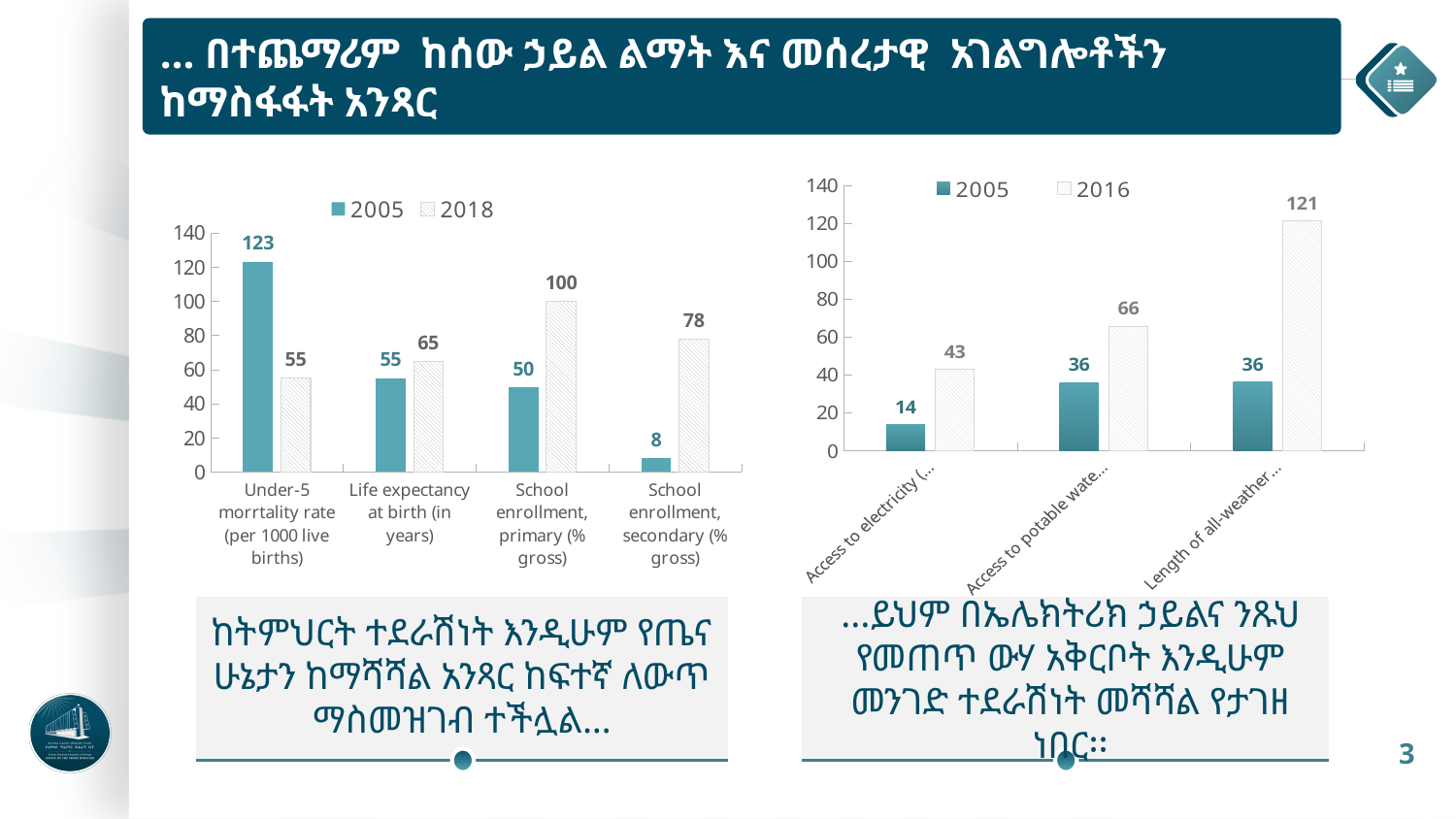
On the left chart, which category has the lowest 2005 value? School enrollment, secondary (% gross) On the right chart, what is the difference between the 2016 and 2005 values for Access to potable water? 30 On the left chart, which two years does the legend list? 2005 and 2018 On the left chart, what is the 2018 value for School enrollment, secondary (% gross)? 78 What type of chart is the right chart? Bar chart On the right chart, which category has the highest 2016 value? Length of all-weather On the left chart, what is the difference between the 2018 and 2005 values for School enrollment, primary (% gross)? 50 On the left chart, what is the 2005 value for Under-5 mortality rate (per 1000 live births)? 123 On the left chart, how many categories are shown on the x axis? 4 On the right chart, what is the 2005 value for Access to electricity? 14 On the left chart, which is larger for Life expectancy at birth (in years): the 2005 value or the 2018 value? 2018 On the right chart, what is the 2016 value for the Length of all-weather category? 121